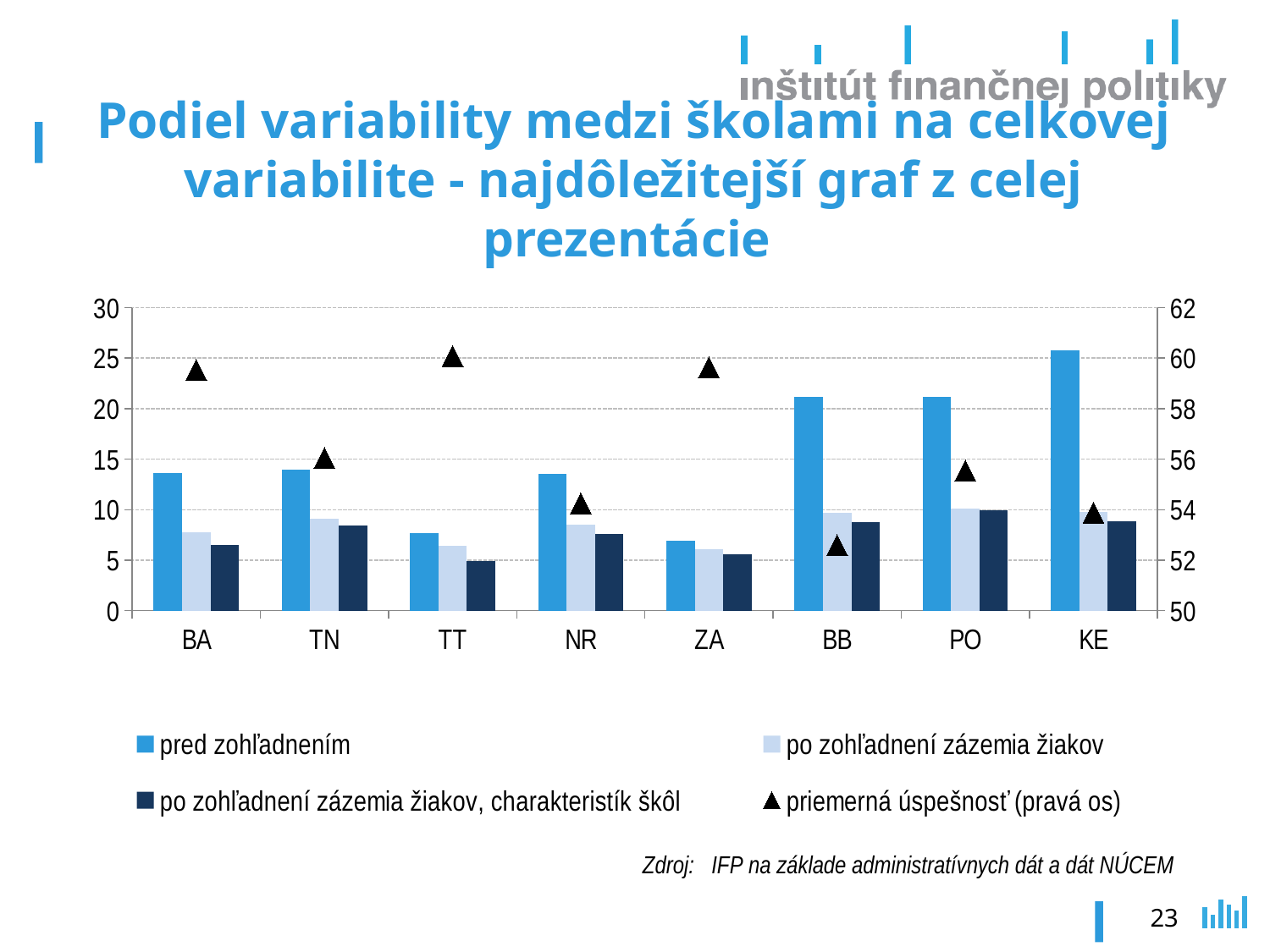
What kind of chart is shown on the slide? bar chart Which region has the lowest value for 'priemerná úspešnosť (pravá os)'? BB Is the 'priemerná úspešnosť (pravá os)' value for BB greater or less than 54 on the right axis? less Which region has the highest value for 'pred zohľadnením'? KE How many regions (categories) are shown on the x axis of the chart? 8 Which is larger, the 'po zohľadnení zázemia žiakov, charakteristík škôl' value for PO or for BA? PO Is the 'pred zohľadnením' value for TT greater or less than 10? less What is the highest tick value shown on the right-hand axis? 62 How many series does the chart legend list? 4 Which is larger, the 'pred zohľadnením' value for BB or for TT? BB Which series is plotted with triangle markers on the right axis? priemerná úspešnosť (pravá os) Is the 'pred zohľadnením' value for KE greater or less than 20? greater